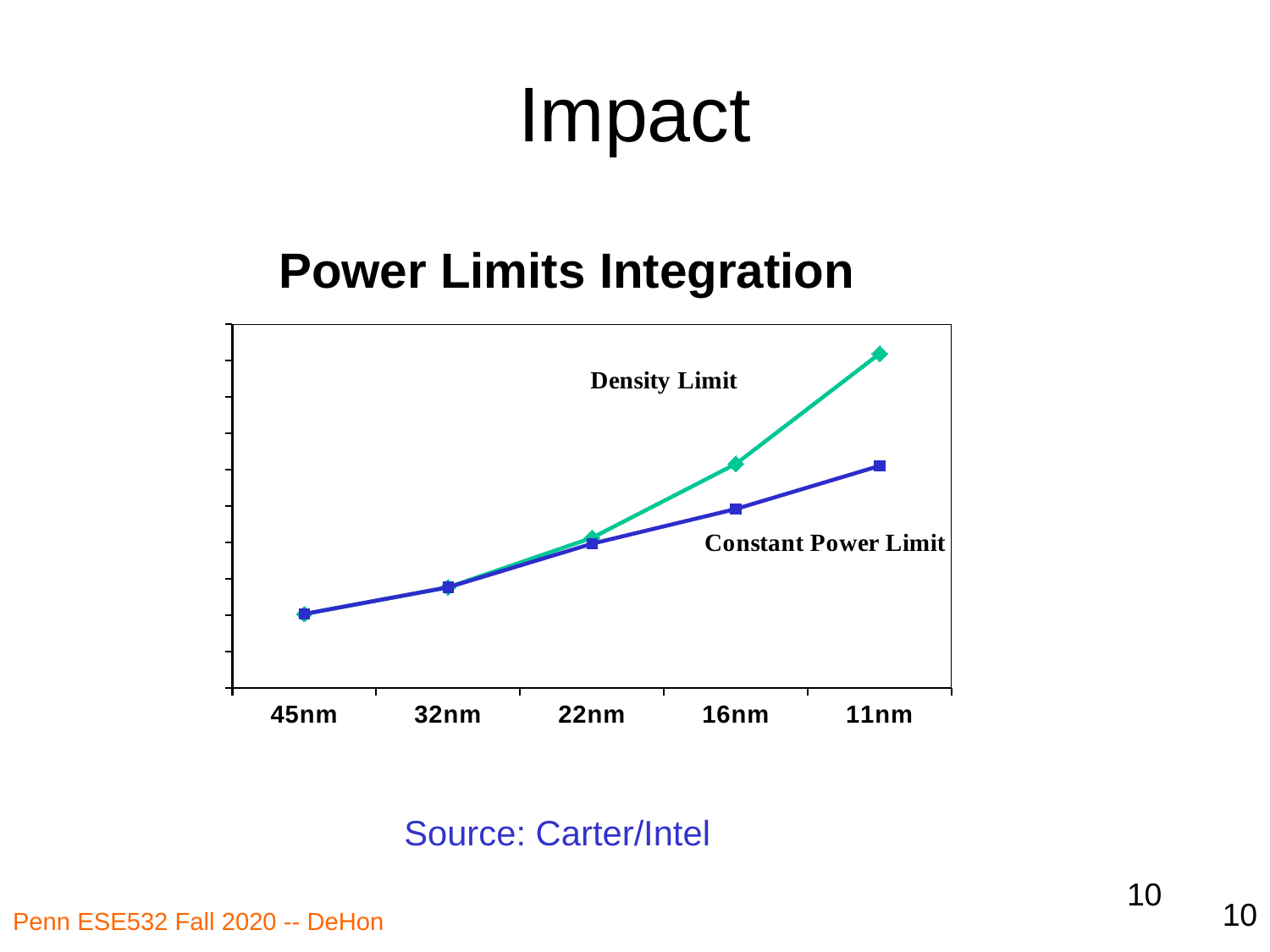
Do the values of the Constant Power Limit series rise or fall moving from 45nm to 11nm along the x axis? rise At which process node does the Constant Power Limit series have its lowest value? 45nm Do the values of the Density Limit series rise or fall moving from 45nm to 11nm along the x axis? rise At 16nm, which series has the larger value, Density Limit or Constant Power Limit? Density Limit What are the names of the two series plotted in the chart? Density Limit and Constant Power Limit What is the title of the chart? Power Limits Integration How many series are plotted in the chart? 2 At 11nm, which series has the larger value, Density Limit or Constant Power Limit? Density Limit How many process nodes are shown along the x axis of the chart? 5 At which process node does the Density Limit series reach its highest value? 11nm Which process node is the first label on the x axis of the chart? 45nm What kind of chart is shown on the slide? line chart